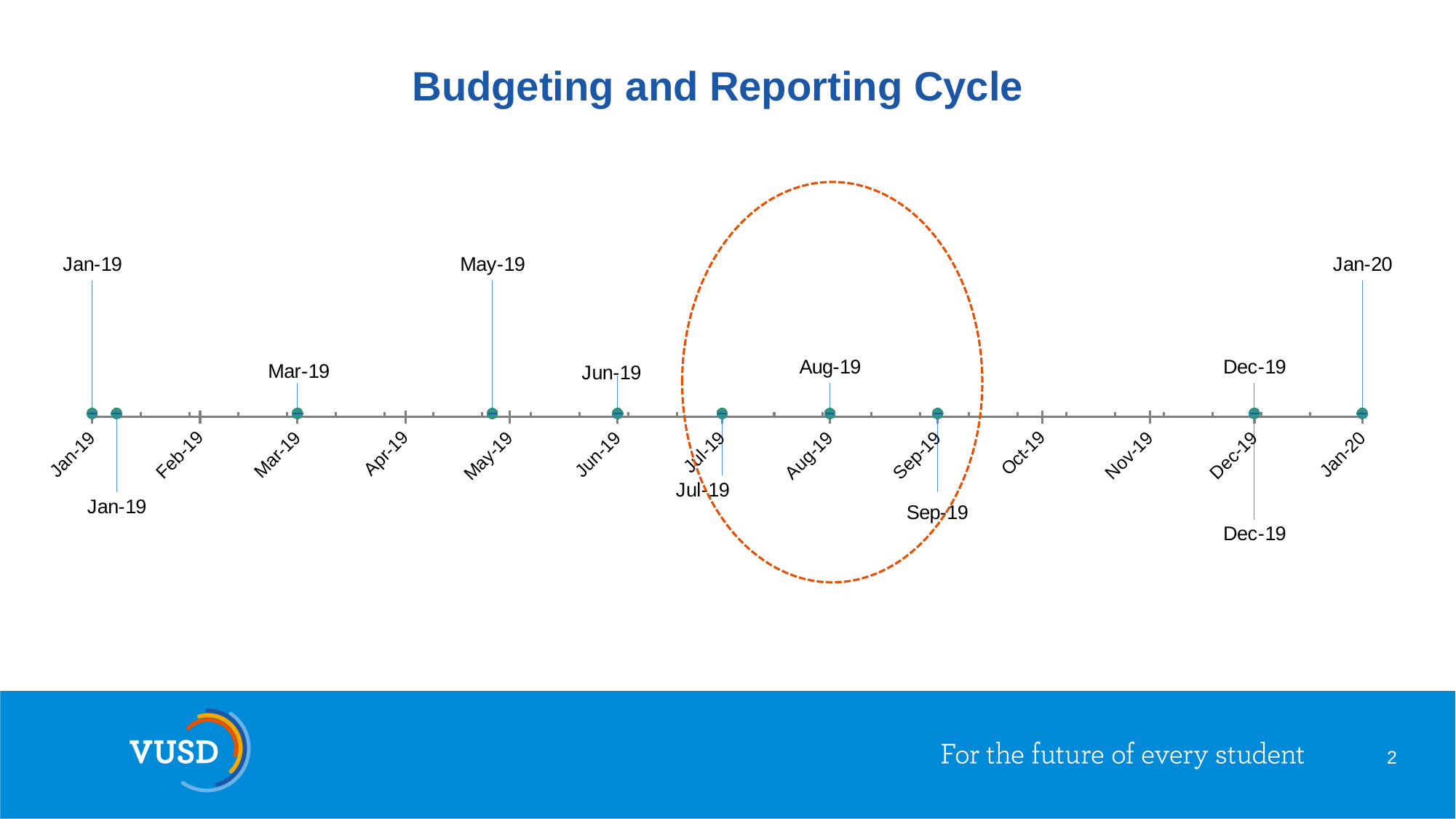
What is the first month label on the horizontal axis of the timeline? Jan-19 What is the last month label on the horizontal axis of the timeline? Jan-20 Which months on the axis between Jan-19 and Jan-20 have no event marker on the timeline? Feb-19, Apr-19, Oct-19 and Nov-19 Which event label on the timeline is placed highest above the axis between Mar-19 and Jun-19? May-19 Which event labels on the timeline are placed below the axis? Jan-19, Jul-19, Sep-19 and Dec-19 What is the title of the chart on the slide? Budgeting and Reporting Cycle Does the timeline show an event marker at Oct-19? No Which month on the timeline has two event labels, one above and one below the axis, at the start of the cycle? Jan-19 How many month labels are shown along the horizontal axis of the timeline? 13 What kind of chart is shown on the slide? A timeline chart Which three months on the timeline are enclosed by the dashed orange oval? Jul-19, Aug-19 and Sep-19 Which month near the end of the timeline has event labels both above and below the axis? Dec-19